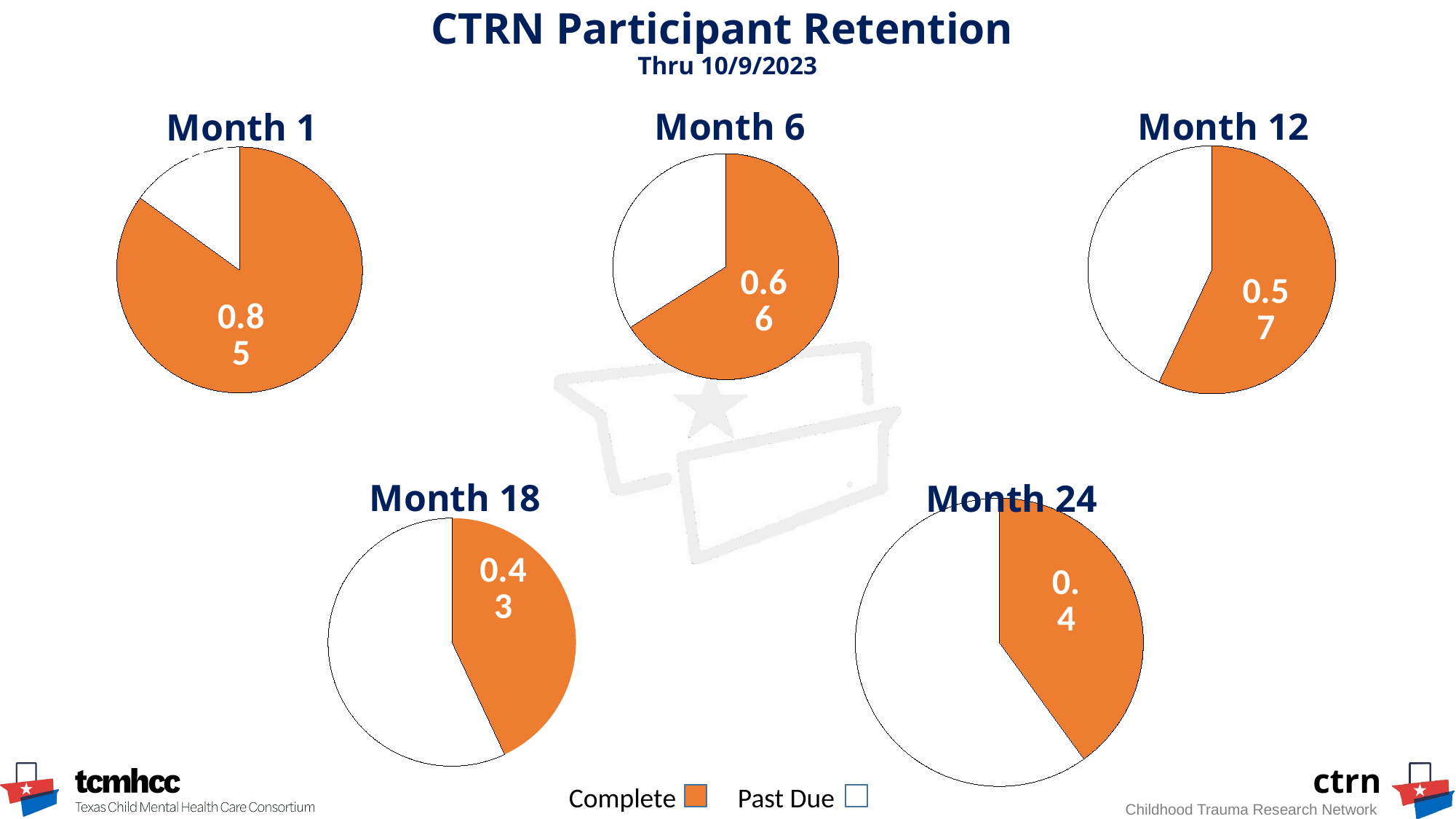
What is the difference between the Complete value in the Month 1 pie chart and the Complete value in the Month 6 pie chart? 0.19 Across the five pie charts, which month has the highest Complete value? Month 1 In the Month 6 pie chart, what is the value shown for the Complete slice? 0.66 Which colour represents Complete in the legend? Orange In the Month 24 pie chart, what is the value shown for the Complete slice? 0.4 In the Month 18 pie chart, what is the value shown for the Complete slice? 0.43 What kind of chart is used for each month on this slide? Pie chart In the Month 1 pie chart, what is the value shown for the Complete slice? 0.85 Across the five pie charts, which month has the lowest Complete value? Month 24 In the Month 12 pie chart, what is the value shown for the Complete slice? 0.57 Is the Complete value larger in the Month 6 pie chart or the Month 12 pie chart? Month 6 How many pie charts are shown on the slide? 5